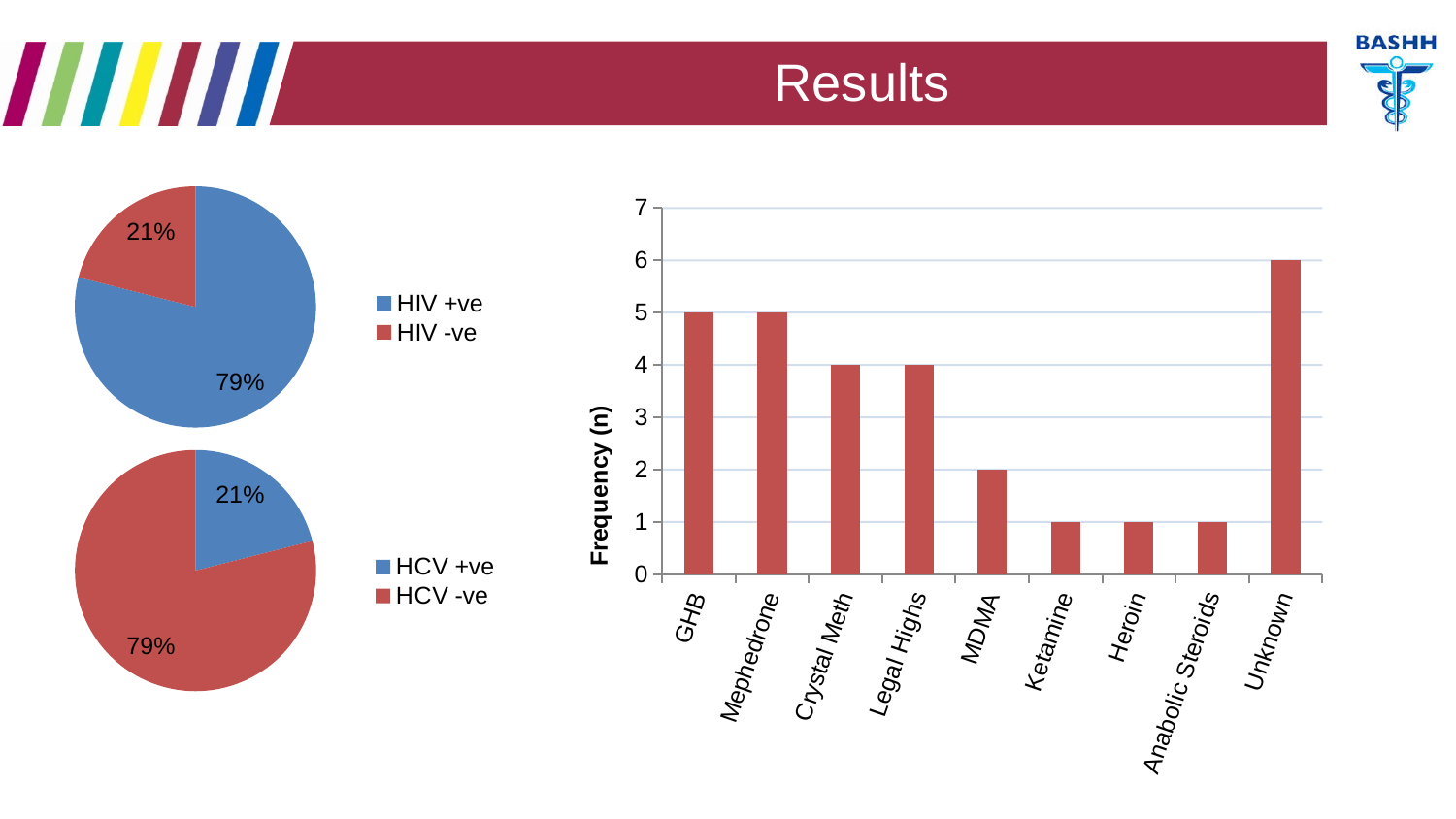
In the top-left pie chart, what share is HIV +ve? 79% In the bar chart on the right, which category has the highest frequency? Unknown In the bar chart on the right, how many categories are shown on the x axis? 9 In the top-left pie chart, what share is HIV -ve? 21% In the bar chart on the right, what is the frequency for MDMA? 2 What is the y-axis label of the bar chart on the right? Frequency (n) In the bar chart on the right, what is the frequency for Unknown? 6 In the bottom-left pie chart, which slice is larger, HCV +ve or HCV -ve? HCV -ve In the bottom-left pie chart, what share is HCV +ve? 21% In the bar chart on the right, what is the difference in frequency between Mephedrone and Crystal Meth? 1 What type of chart is shown on the right side of the slide? Bar chart In the bar chart on the right, what is the frequency for GHB? 5